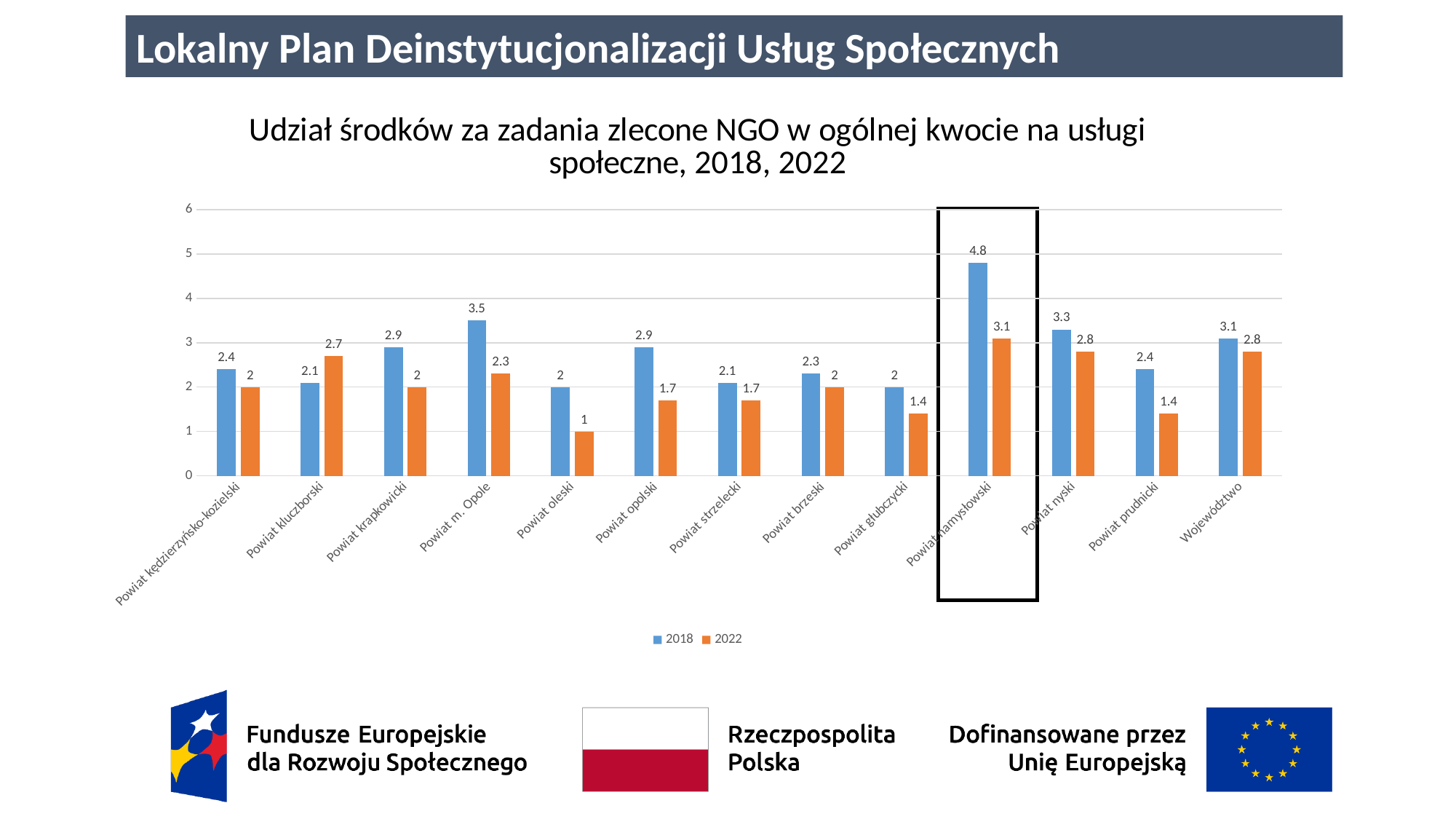
How many categories are shown on the x axis? 13 Which category has the lowest 2022 value? Powiat oleski How many series does the legend list? 2 What is the 2018 value for Powiat namysłowski? 4.8 What kind of chart is shown on the slide? Bar chart Is the 2018 value for Powiat m. Opole greater or less than 3? greater What is the 2022 value for Województwo? 2.8 What is the 2022 value for Powiat oleski? 1 Which series is shown in orange? 2022 What is the difference between the 2018 and 2022 values for Powiat namysłowski? 1.7 Which is larger for Powiat kluczborski, the 2018 value or the 2022 value? 2022 Which category has the highest 2018 value? Powiat namysłowski